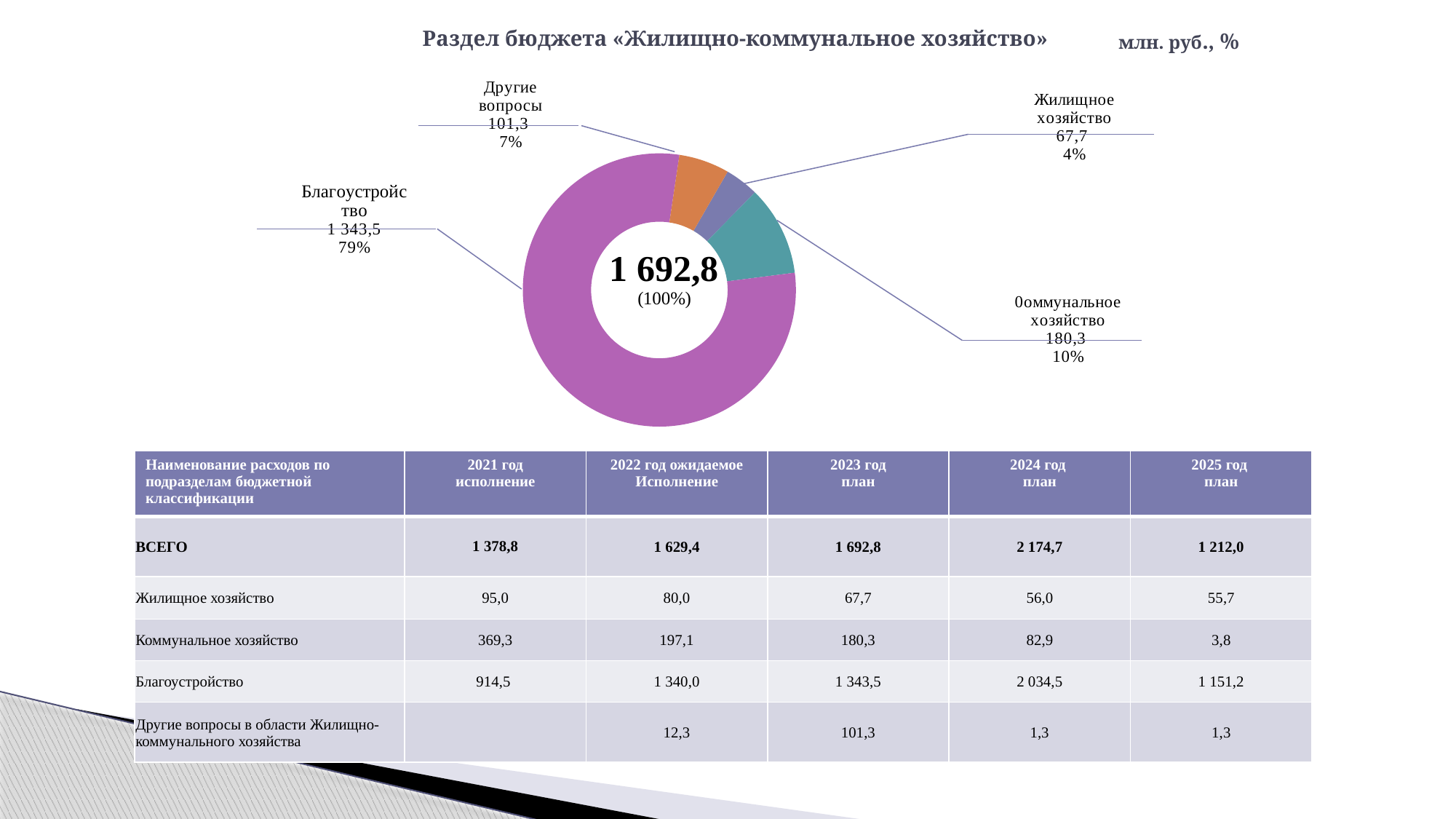
What is the difference between the values for Коммунальное хозяйство and Другие вопросы in the donut chart? 79,0 How many slices does the donut chart have? 4 Which category has the largest slice in the donut chart? Благоустройство What share of the donut chart does Благоустройство represent? 79% What is the value for Коммунальное хозяйство in the donut chart? 180,3 Which is larger in the donut chart: Коммунальное хозяйство or Жилищное хозяйство? Коммунальное хозяйство What share of the donut chart does Другие вопросы represent? 7% What kind of chart is shown on the slide? Donut (pie) chart What is the value for Благоустройство in the donut chart? 1 343,5 Which category has the smallest slice in the donut chart? Жилищное хозяйство What total value is shown in the centre of the donut chart? 1 692,8 What is the value for Жилищное хозяйство in the donut chart? 67,7